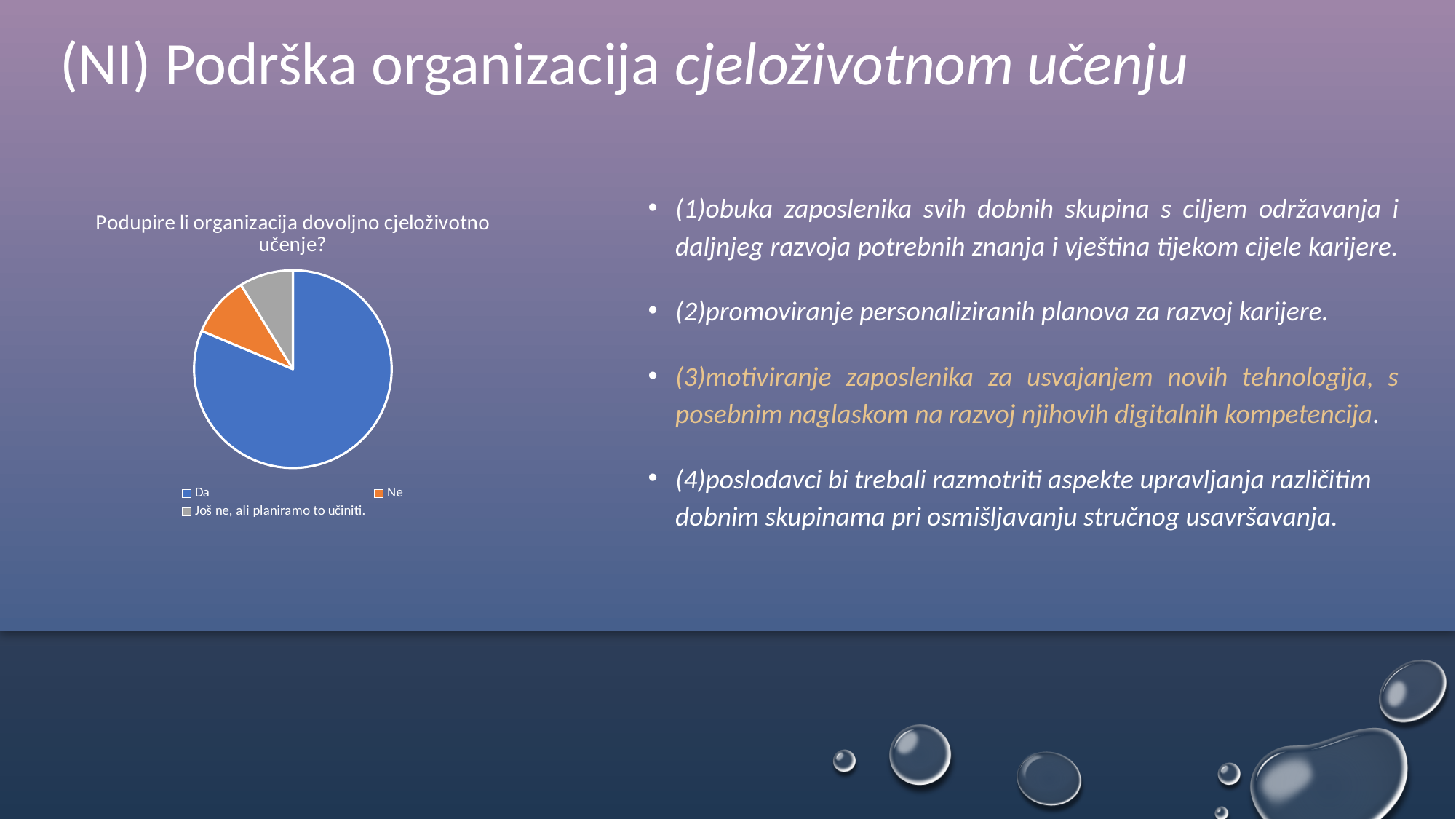
Which colour represents the Ne category in the pie chart? orange How many slices does the pie chart have? 3 What is the title of the pie chart? Podupire li organizacija dovoljno cjeloživotno učenje? Which slice is larger in the pie chart, Da or Ne? Da How many entries does the legend of the pie chart list? 3 What kind of chart is shown on the slide? pie chart Which category has the largest slice in the pie chart? Da Which slice is larger in the pie chart, Da or Još ne, ali planiramo to učiniti? Da